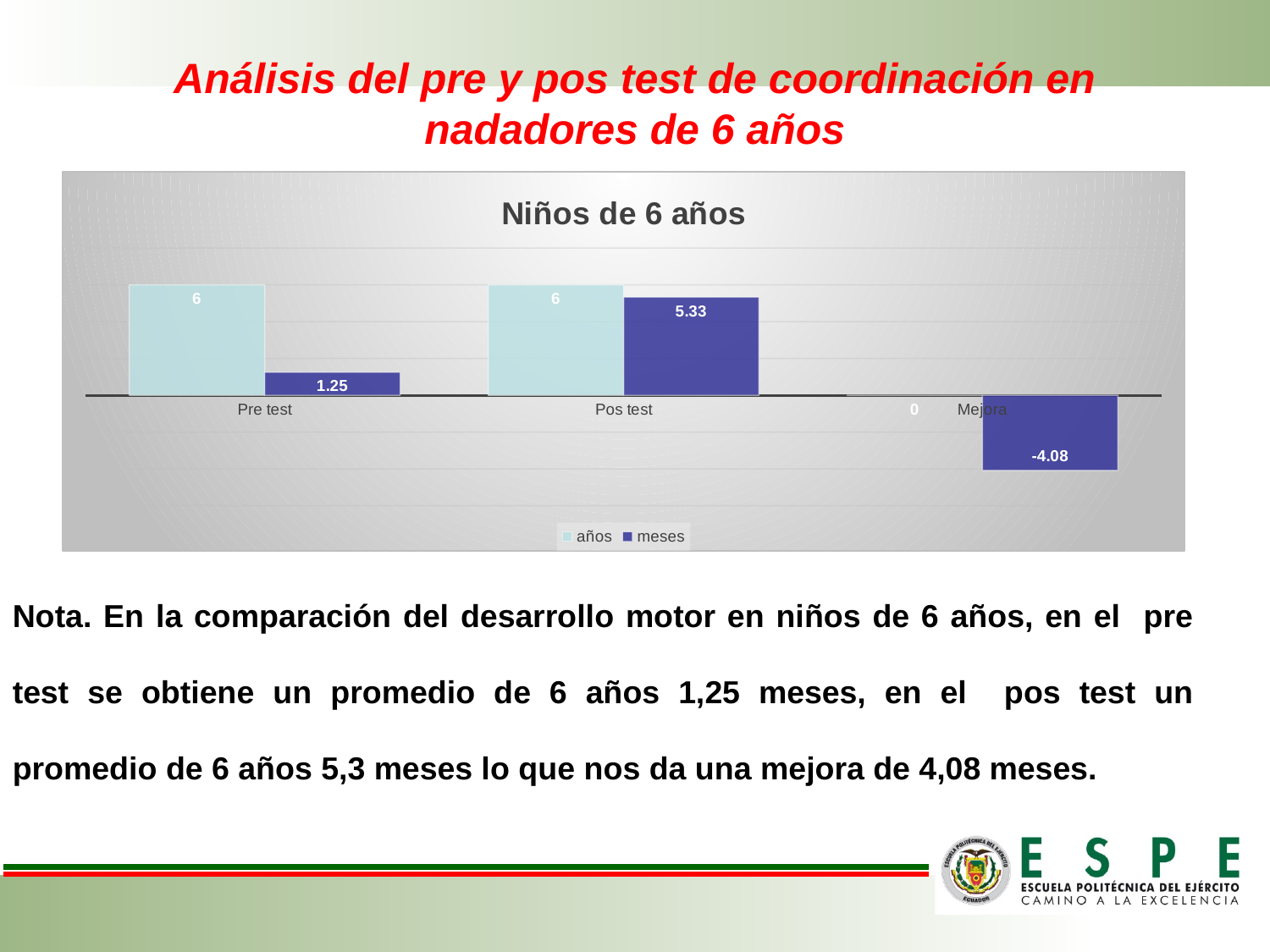
What is the value of 'meses' for Mejora? -4.08 What is the value of 'años' for Mejora? 0 How many categories are shown on the x axis of the chart? 3 What type of chart is shown on the slide? bar chart Which category has the lowest 'meses' value? Mejora Which category has the highest 'meses' value? Pos test What is the value of 'meses' for Pos test? 5.33 What is the value of 'meses' for Pre test? 1.25 What is the title of the chart? Niños de 6 años What is the difference between the 'meses' values for Pos test and Pre test? 4.08 How many series does the chart legend list? 2 What is the value of 'años' for Pos test? 6